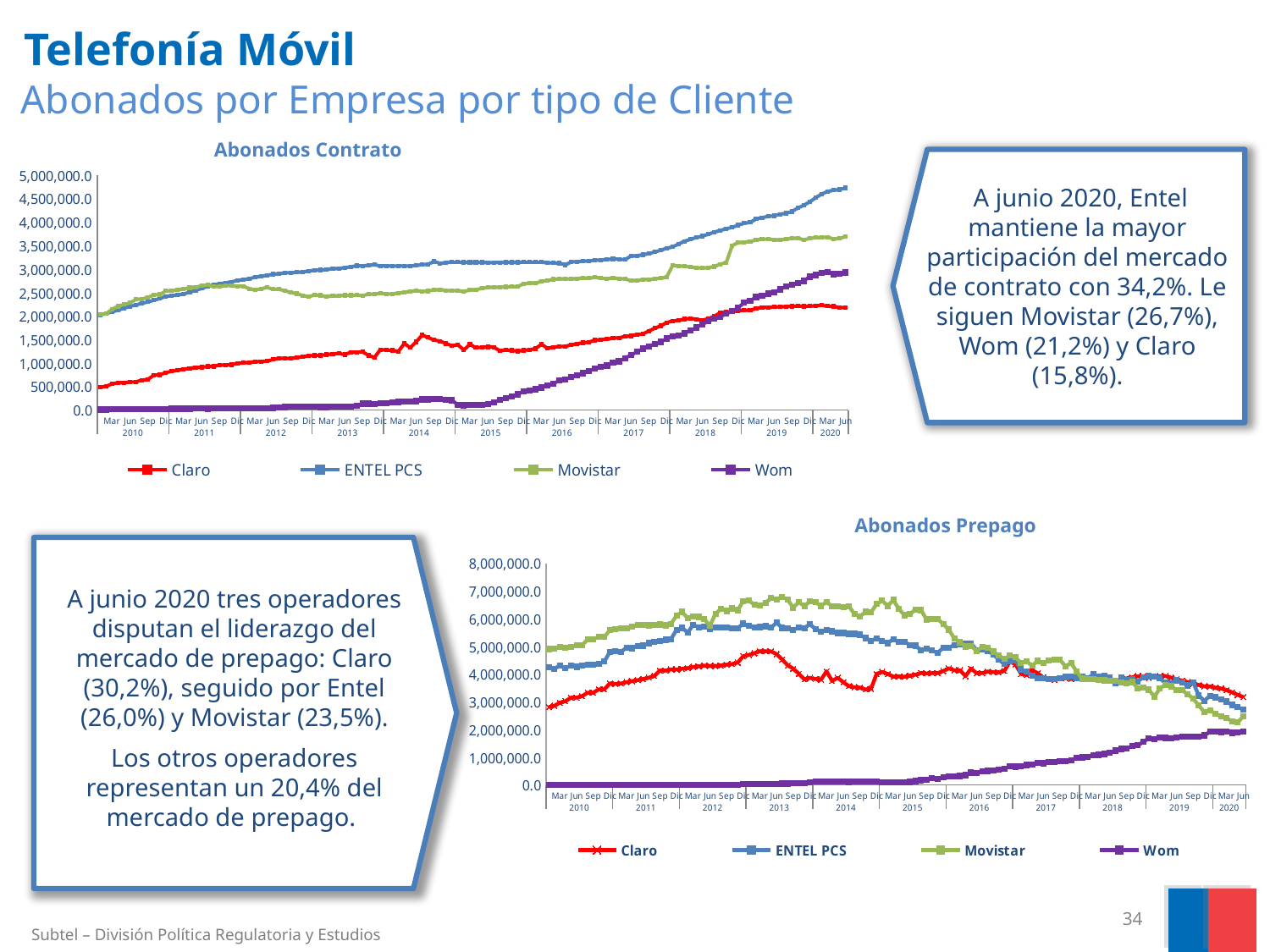
In the 'Abonados Prepago' chart, which series has the lowest value at Jun 2020? Wom In the 'Abonados Contrato' chart, which series has the highest value at Jun 2020? ENTEL PCS In the 'Abonados Contrato' chart, does the Wom series rise or fall from 2015 to 2020? rise In the 'Abonados Contrato' chart, is the value for ENTEL PCS at Jun 2020 greater or less than 4,000,000? greater In the 'Abonados Contrato' chart, is the value for Wom in Mar 2010 greater or less than 500,000? less In the 'Abonados Prepago' chart, is the peak value for Movistar in 2013 greater or less than 6,000,000? greater What kind of chart is the 'Abonados Prepago' chart? line chart What kind of chart is the 'Abonados Contrato' chart? line chart How many series does the legend of the 'Abonados Contrato' chart list? 4 In the 'Abonados Prepago' chart, does the Movistar series rise or fall from 2016 to 2020? fall In the 'Abonados Contrato' chart, which series has the lowest value at Jun 2020? Claro In the 'Abonados Prepago' chart, which series are listed in the legend? Claro, ENTEL PCS, Movistar, Wom